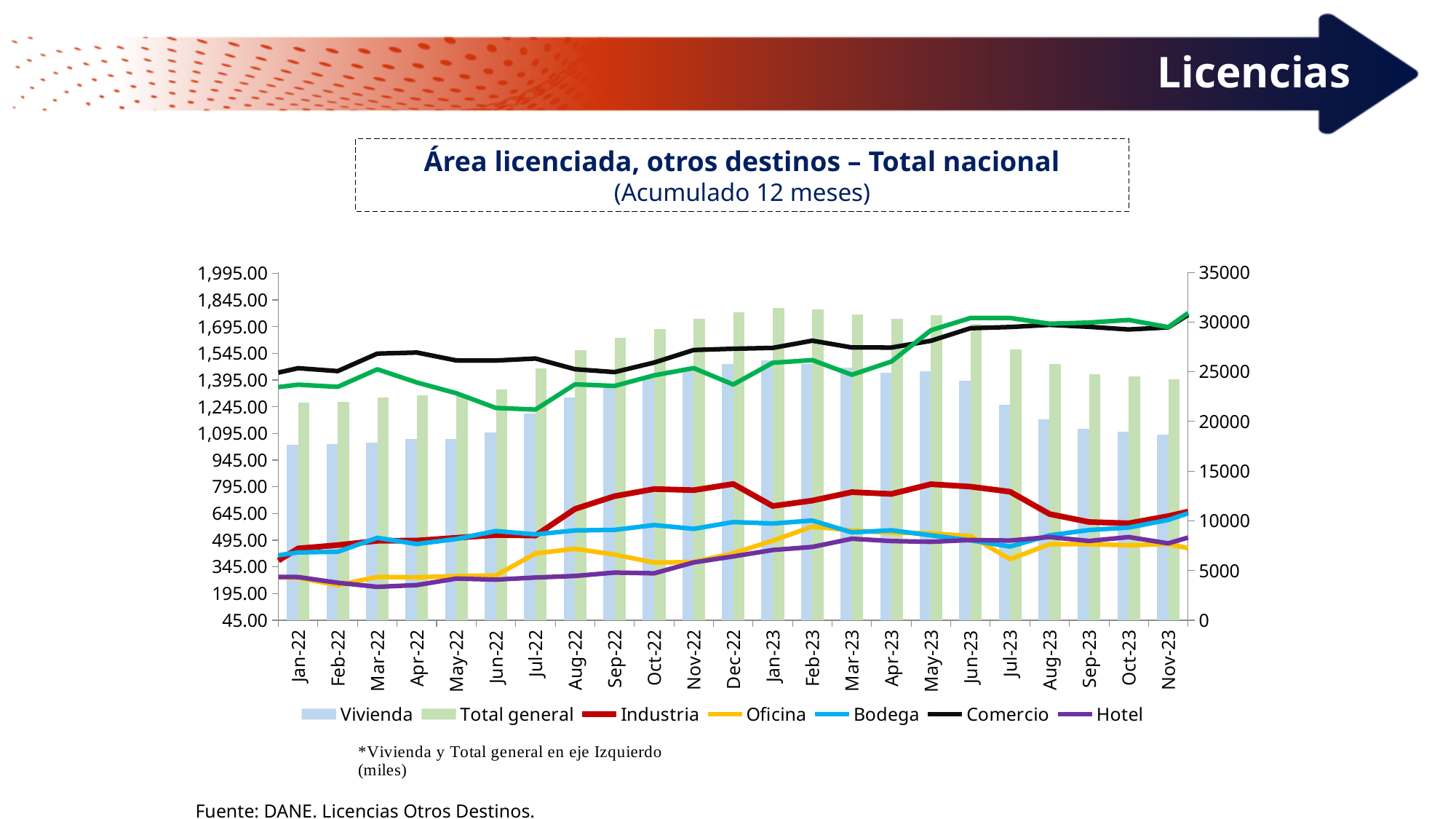
How many months are shown along the x axis? 23 How many series does the legend list? 7 Is the Industria value for Dec-22 greater or less than 10000 on the right axis? greater Is the Comercio value for Jan-22 greater or less than 20000 on the right axis? greater Is the Total general value for Jan-23 greater or less than 1,695.00? greater Does the Comercio line generally rise or fall from Jan-22 to Nov-23? rise What is the title of the chart? Área licenciada, otros destinos – Total nacional (Acumulado 12 meses) Which two series are plotted on the left axis according to the note below the chart? Vivienda and Total general What kind of chart is shown on the slide? A combination bar and line chart Which is larger in Dec-22, Industria or Hotel? Industria